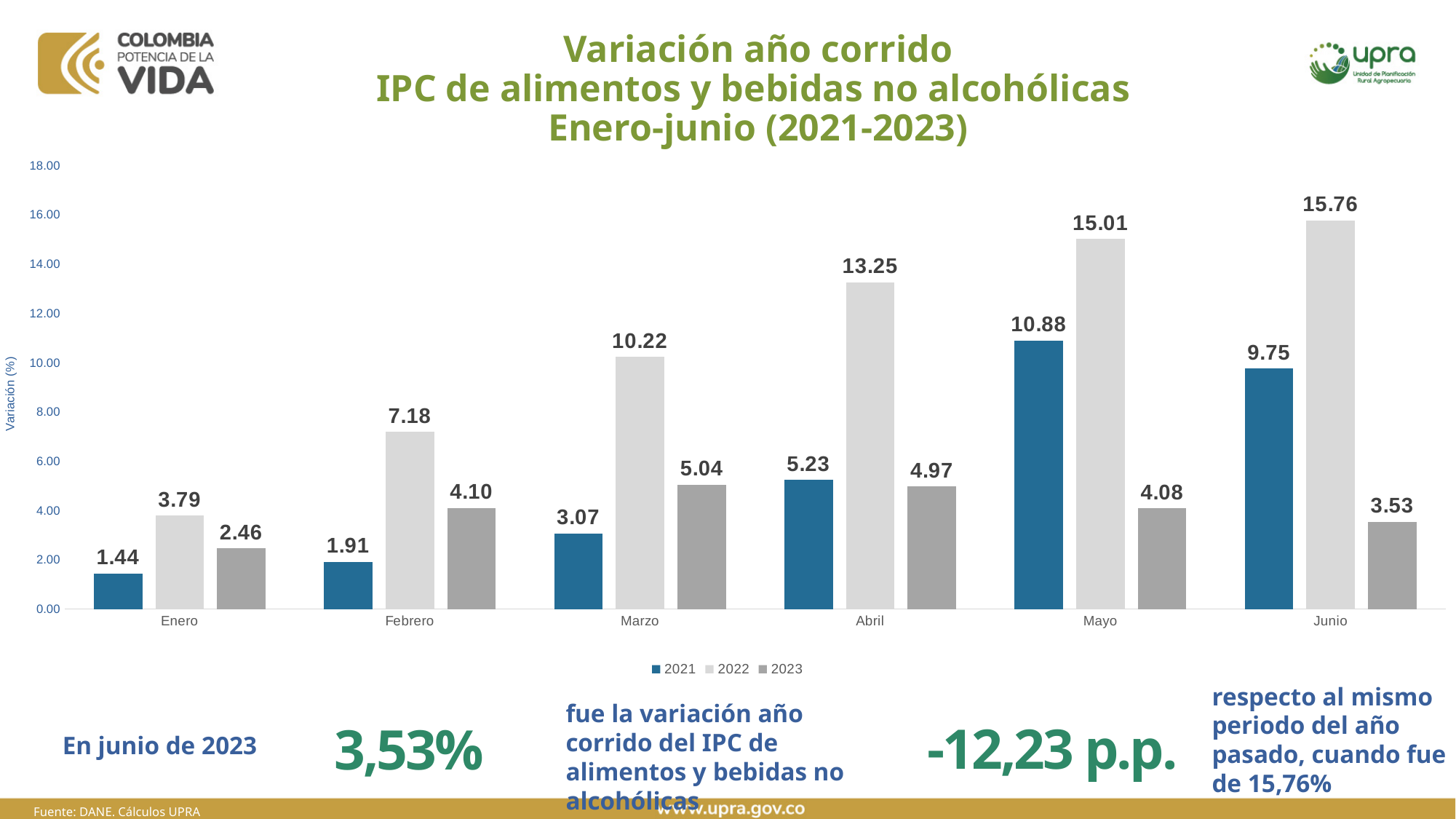
How many series does the legend list? 3 Which month has the highest value for the 2021 series? Mayo What is the label of the y axis? Variación (%) What is the value for 2021 in Marzo? 3.07 What is the difference between the 2022 and 2023 values in Junio? 12.23 What is the value for 2023 in Abril? 4.97 How many months are shown on the x axis? 6 Does the 2022 series rise or fall from Enero to Junio? Rise What kind of chart is shown on the slide? Bar chart Which month has the lowest value for the 2023 series? Enero Which is larger in Abril: the 2021 value or the 2023 value? 2021 What is the value for 2022 in Junio? 15.76